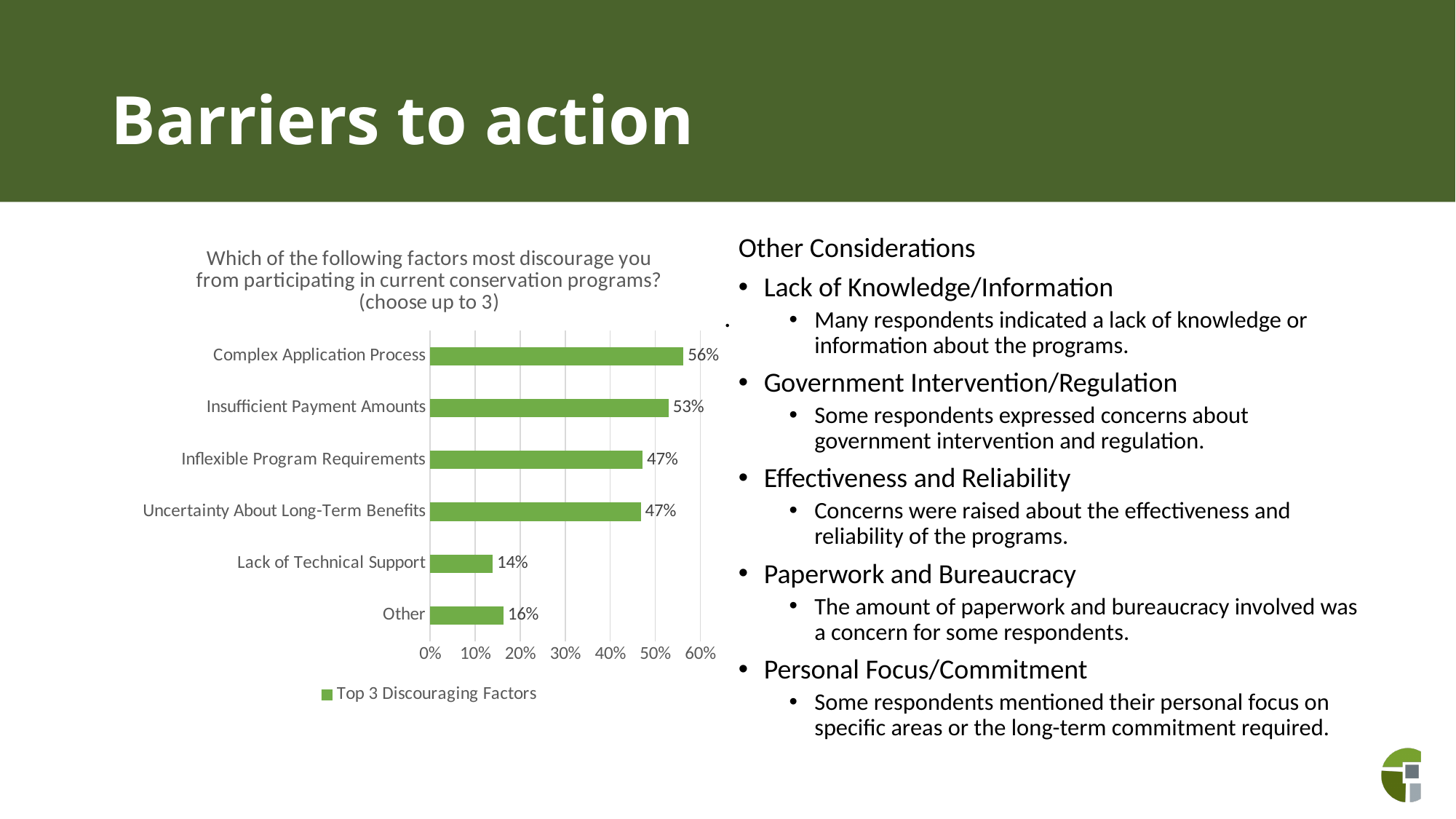
What is the legend entry for the series in the chart? Top 3 Discouraging Factors What is the value for Lack of Technical Support? 14% What percentage of respondents chose Complex Application Process as a discouraging factor? 56% What is the difference between Inflexible Program Requirements and Lack of Technical Support? 33% What kind of chart is shown on the slide? Bar chart Which factor has the highest percentage? Complex Application Process What is the difference between Complex Application Process and Insufficient Payment Amounts? 3% What is the value for Other? 16% Which is larger, the value for Other or the value for Lack of Technical Support? Other What is the value for Insufficient Payment Amounts? 53% Which factor has the lowest percentage? Lack of Technical Support How many factors (categories) are shown in the chart? 6